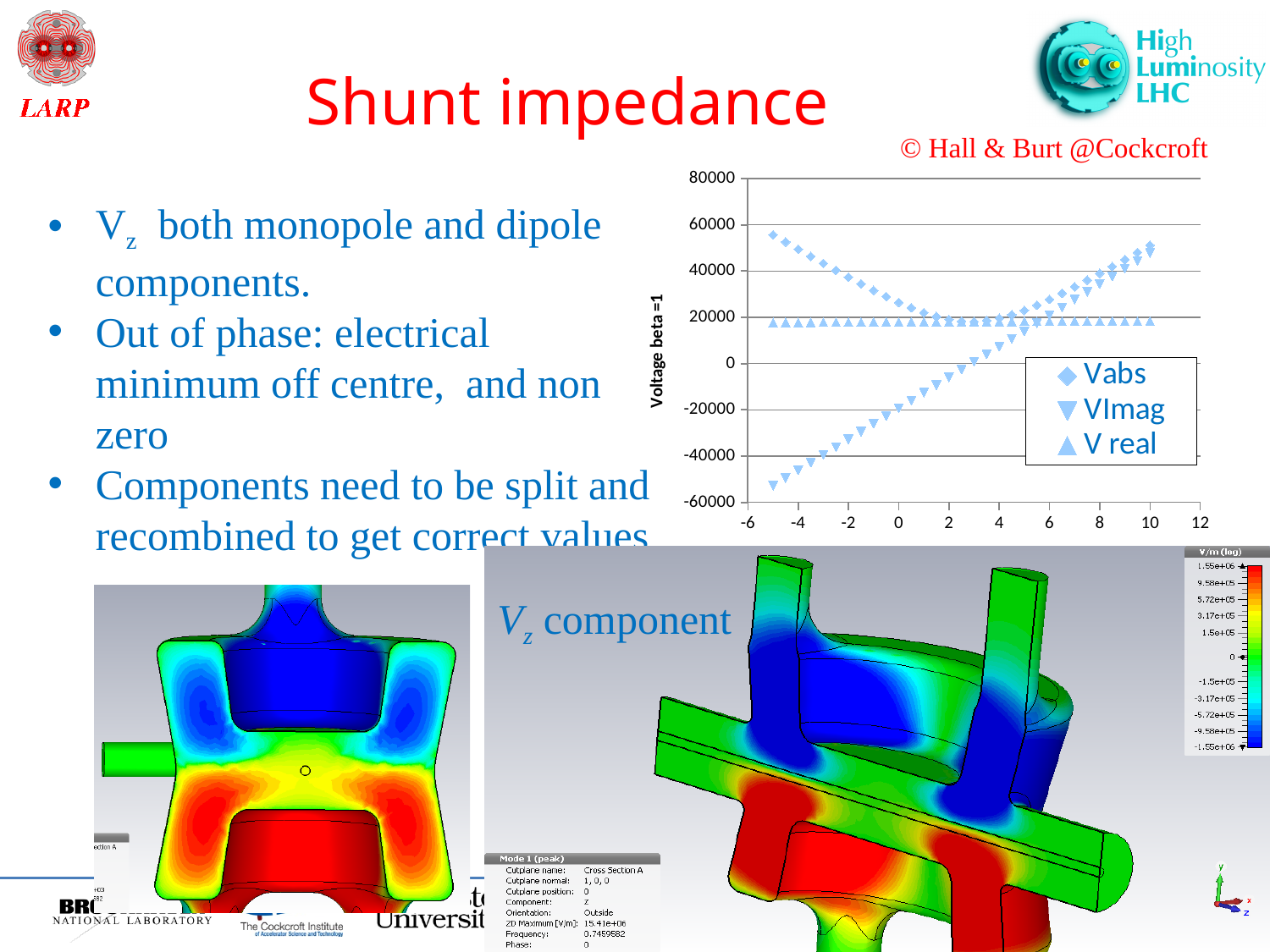
What are the three series named in the chart legend? Vabs, VImag, V real What kind of chart is shown on the slide? scatter chart How many series does the chart legend list? 3 Is the value of the Vabs series at x = -5 greater or less than 40000? greater Does the VImag series rise or fall as x increases from -5 to 10? rise Is the value of the VImag series at x = 8 greater or less than 20000? greater At x = 10, which series has the larger value, Vabs or V real? Vabs Is the value of the Vabs series at x = 2 greater or less than 40000? less What is the title of the chart's vertical axis? Voltage beta =1 At x = -4, which series has the larger value, Vabs or VImag? Vabs